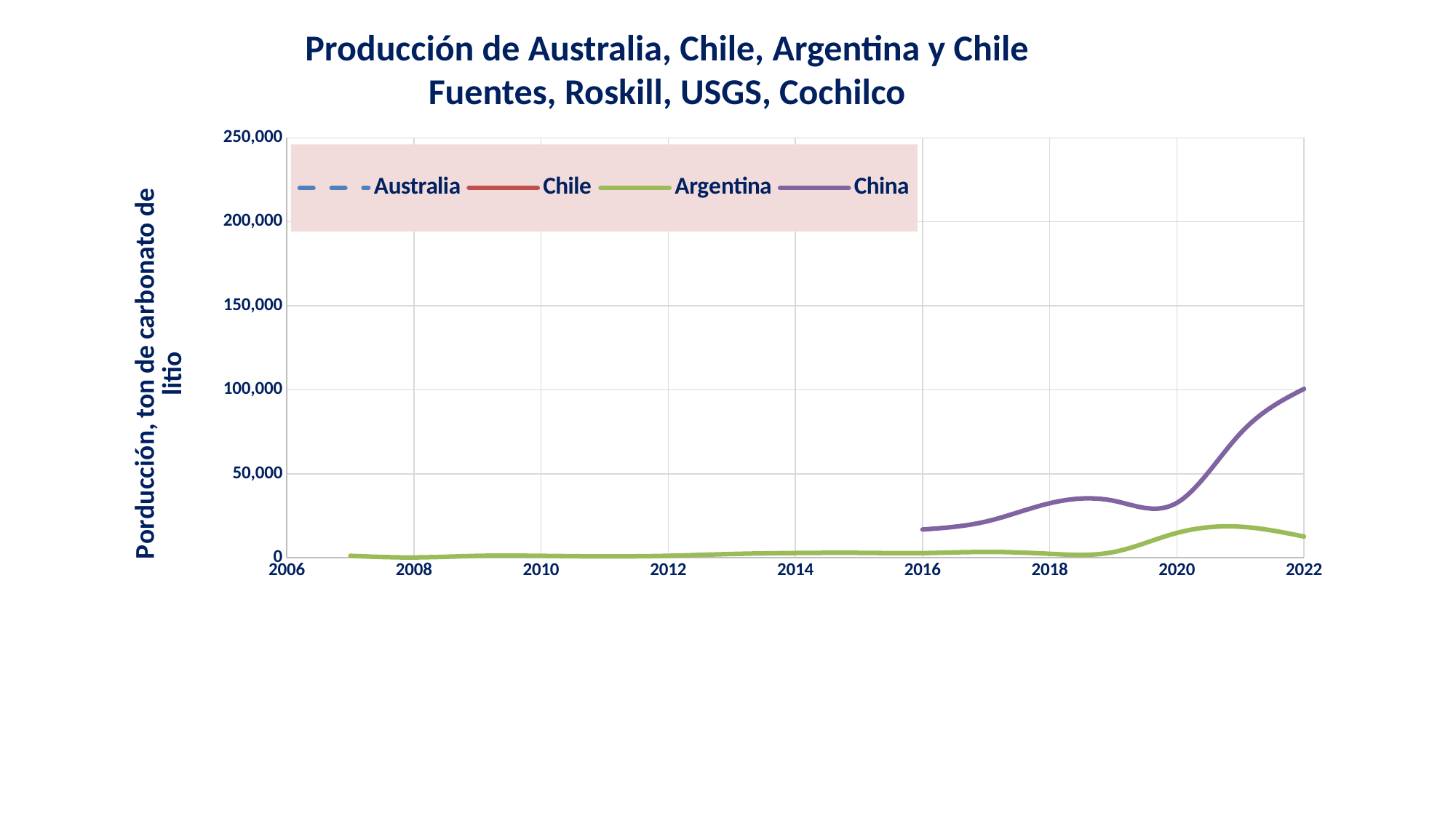
What is the label of the vertical axis? Porducción, ton de carbonato de litio Is the value for China in 2022 greater or less than 50,000? greater Is the value for Argentina in 2022 greater or less than 50,000? less What kind of chart is shown on the slide? line chart Which series are listed in the legend? Australia, Chile, Argentina, China How many series does the legend list? 4 Does the value for China rise or fall from 2016 to 2022? rise Is the value for China in 2018 greater or less than 100,000? less Which plotted series reaches the highest value on the chart? China Which is larger in 2020, the value for China or the value for Argentina? China Which is larger in 2022, the value for China or the value for Argentina? China